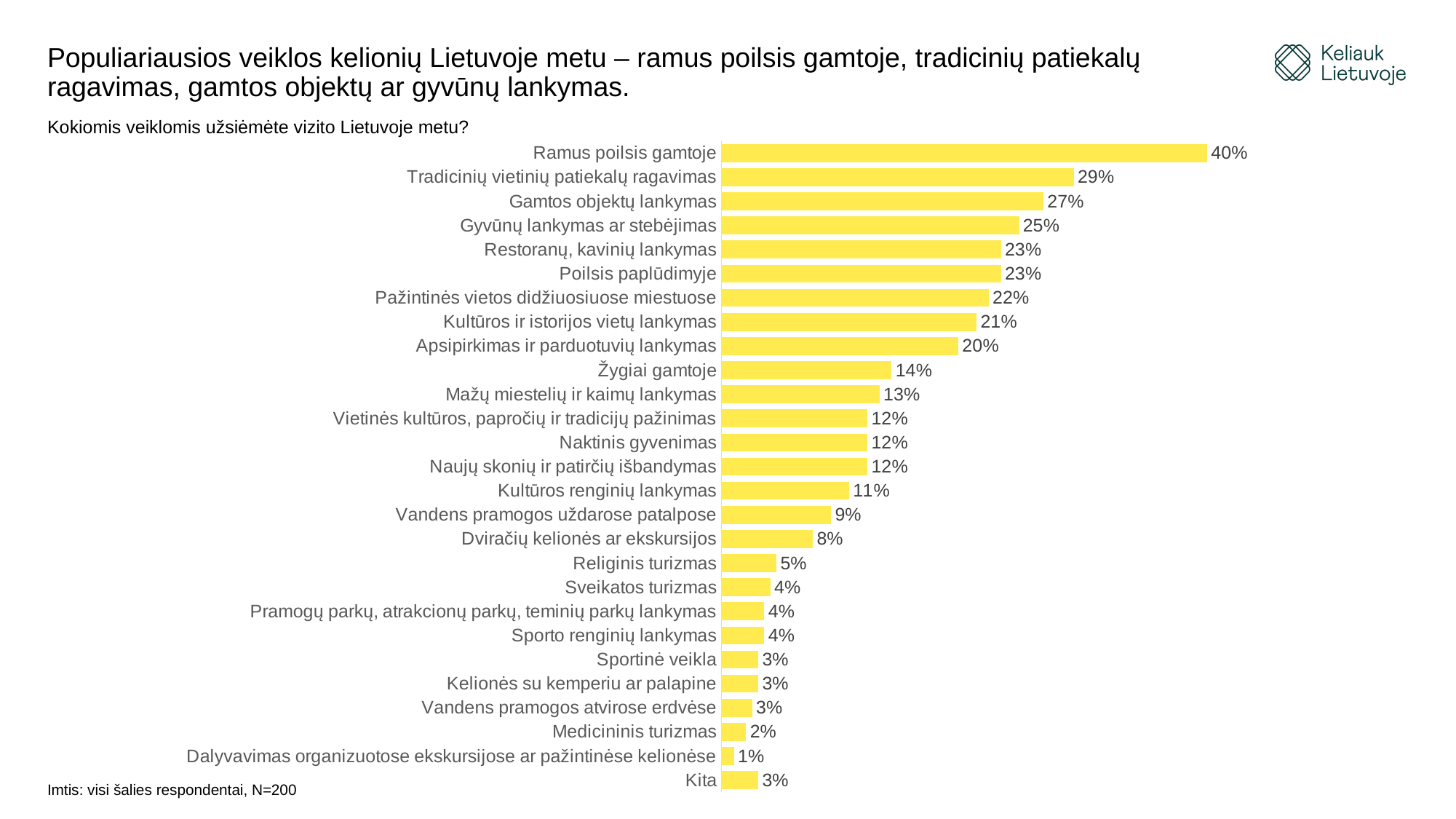
Which activity has the lowest percentage? Dalyvavimas organizuotose ekskursijose ar pažintinėse kelionėse What is the value for "Medicininis turizmas"? 2% Which is larger, "Gyvūnų lankymas ar stebėjimas" or "Kultūros ir istorijos vietų lankymas"? Gyvūnų lankymas ar stebėjimas What is the difference between "Gamtos objektų lankymas" and "Apsipirkimas ir parduotuvių lankymas"? 7% What percentage of respondents chose "Ramus poilsis gamtoje"? 40% Which activity has the highest percentage? Ramus poilsis gamtoje What question is the chart based on, as shown above it? Kokiomis veiklomis užsiėmėte vizito Lietuvoje metu? What percentage is shown for "Dviračių kelionės ar ekskursijos"? 8% What is the value shown for "Žygiai gamtoje"? 14% What type of chart is shown on the slide? Bar chart How many activity categories are shown in the chart? 27 What is the difference between "Ramus poilsis gamtoje" and "Tradicinių vietinių patiekalų ragavimas"? 11%